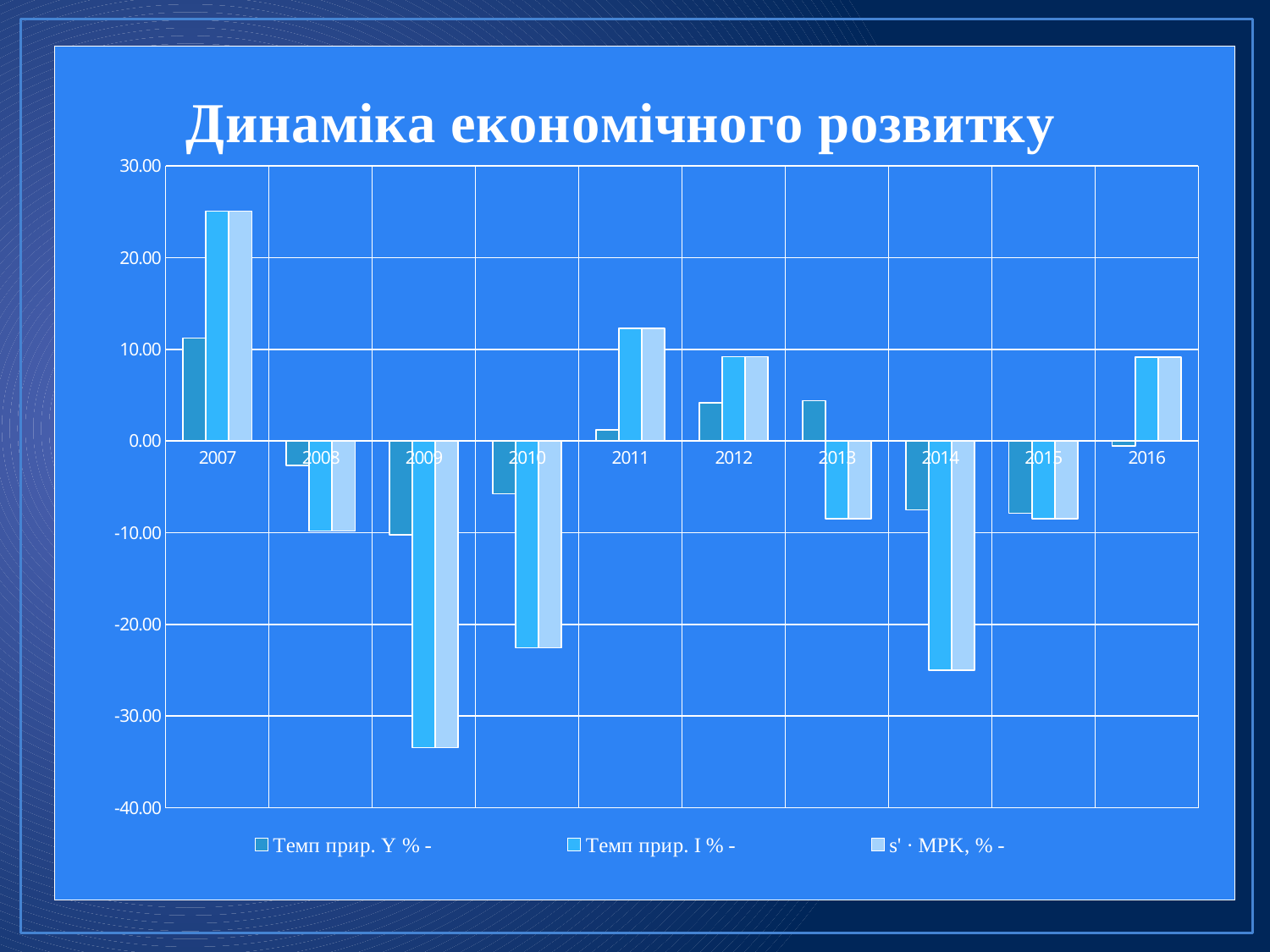
How many series does the legend list? 3 Is the value for "Темп прир. I % -" in 2014 greater or less than -20? less In which year is the value for "Темп прир. Y % -" highest? 2007 In which year is the value for "Темп прир. I % -" lowest? 2009 Is the value for "Темп прир. I % -" in 2009 greater or less than -30? less Is the value for "Темп прир. I % -" in 2007 greater or less than 20? greater How many years are shown on the x axis? 10 Which is larger, the value for "Темп прир. I % -" in 2007 or in 2011? 2007 Which is larger, the value for "Темп прир. Y % -" in 2013 or in 2014? 2013 In which year is the value for "Темп прир. I % -" highest? 2007 What kind of chart is shown on the slide? bar chart What is the title of the chart? Динаміка економічного розвитку